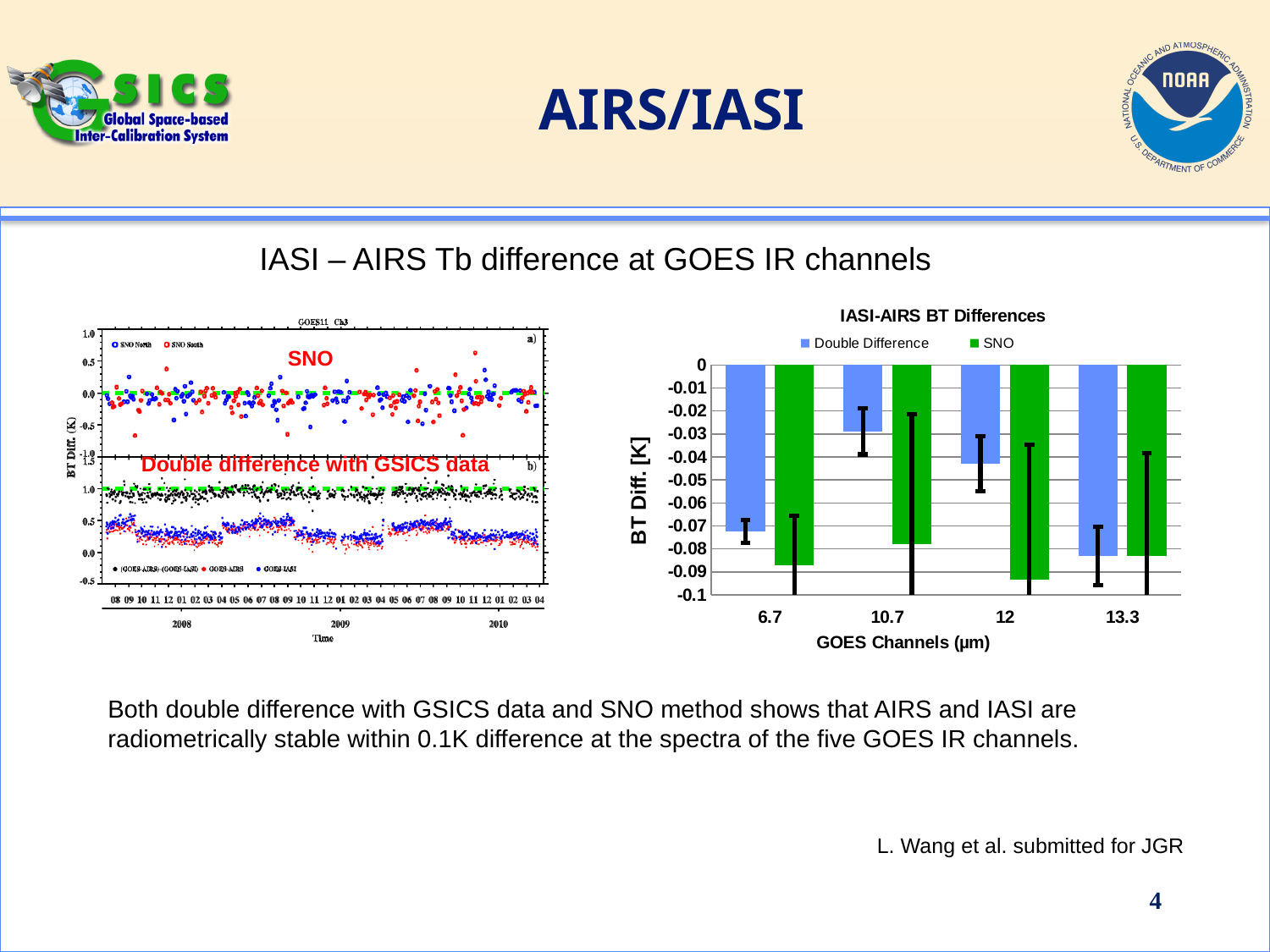
In the 'IASI-AIRS BT Differences' chart, is the Double Difference value for the 6.7 channel greater or less than -0.05? less In the chart titled 'IASI-AIRS BT Differences', how many series does the legend list? 2 In the chart titled 'IASI-AIRS BT Differences', how many GOES channel categories are shown on the x axis? 4 In the 'IASI-AIRS BT Differences' chart, at the 12 channel, which series has the more negative value, Double Difference or SNO? SNO In the 'IASI-AIRS BT Differences' chart, which GOES channel has the most negative Double Difference value? 13.3 In the 'IASI-AIRS BT Differences' chart, is the Double Difference value for the 10.7 channel greater or less than -0.05? greater What is the y-axis label of the 'IASI-AIRS BT Differences' chart? BT Diff. [K] In the 'IASI-AIRS BT Differences' chart, at the 10.7 channel, which series has the more negative value, Double Difference or SNO? SNO In the 'IASI-AIRS BT Differences' chart, which colour represents the SNO series? green What kind of chart is the 'IASI-AIRS BT Differences' chart on the right of the slide? bar chart In the 'IASI-AIRS BT Differences' chart, is the SNO value for the 12 channel greater or less than -0.08? less In the 'IASI-AIRS BT Differences' chart, which GOES channel has the Double Difference value closest to zero? 10.7